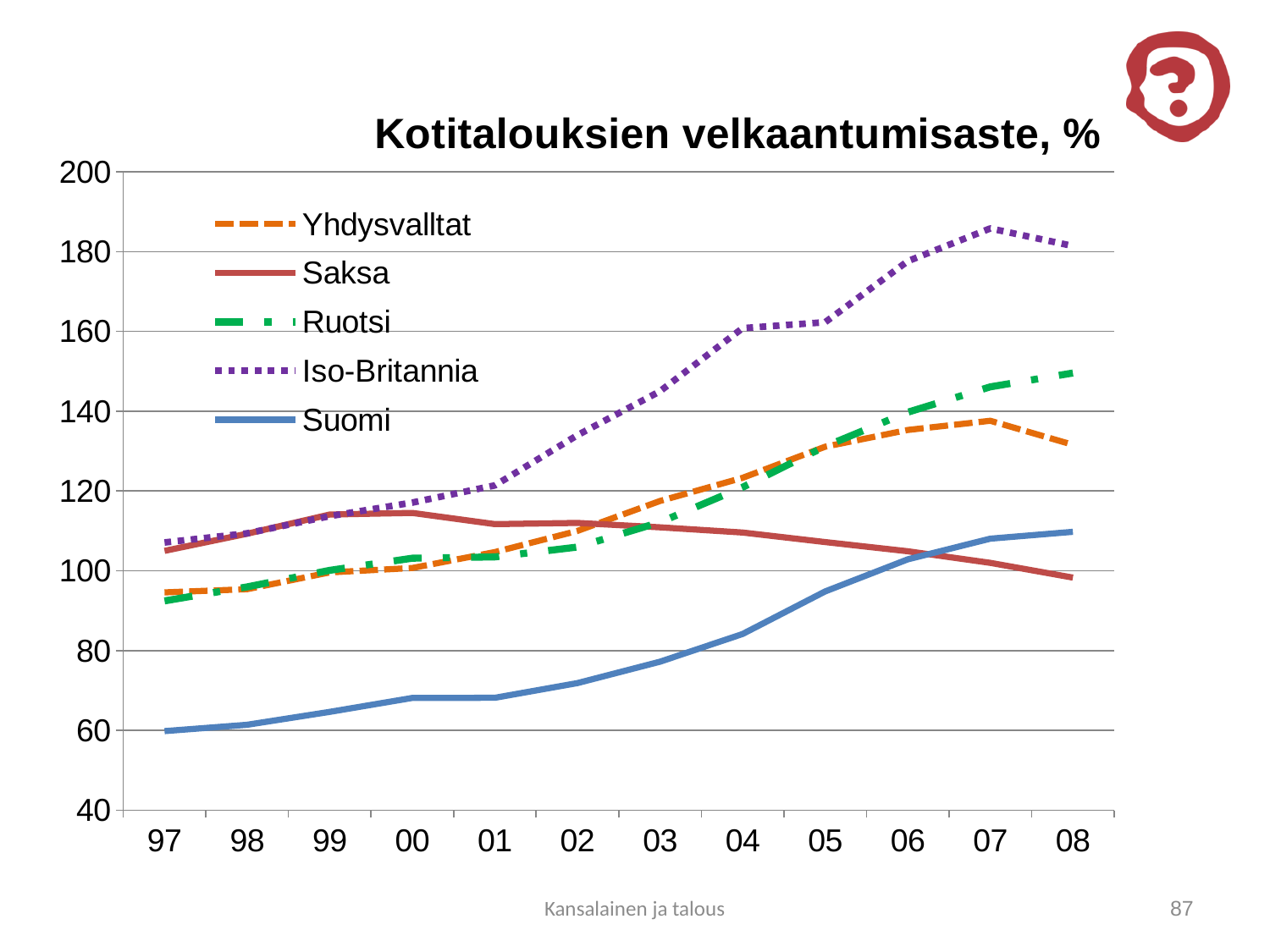
Which series has the lowest value in 08? Saksa What is the title of the chart? Kotitalouksien velkaantumisaste, % Is the value for Iso-Britannia in 07 greater or less than 180? greater Which series has the highest value in 08? Iso-Britannia In 08, which is larger, the value for Ruotsi or the value for Yhdysvallat? Ruotsi How many series does the legend list? 5 Is the value for Ruotsi in 08 greater or less than 140? greater What kind of chart is shown on the slide? line chart How many years are shown on the x axis? 12 Is the value for Suomi in 97 greater or less than 80? less Which series has the lowest value in 97? Suomi Does the value for Suomi rise or fall from 97 to 08? rise